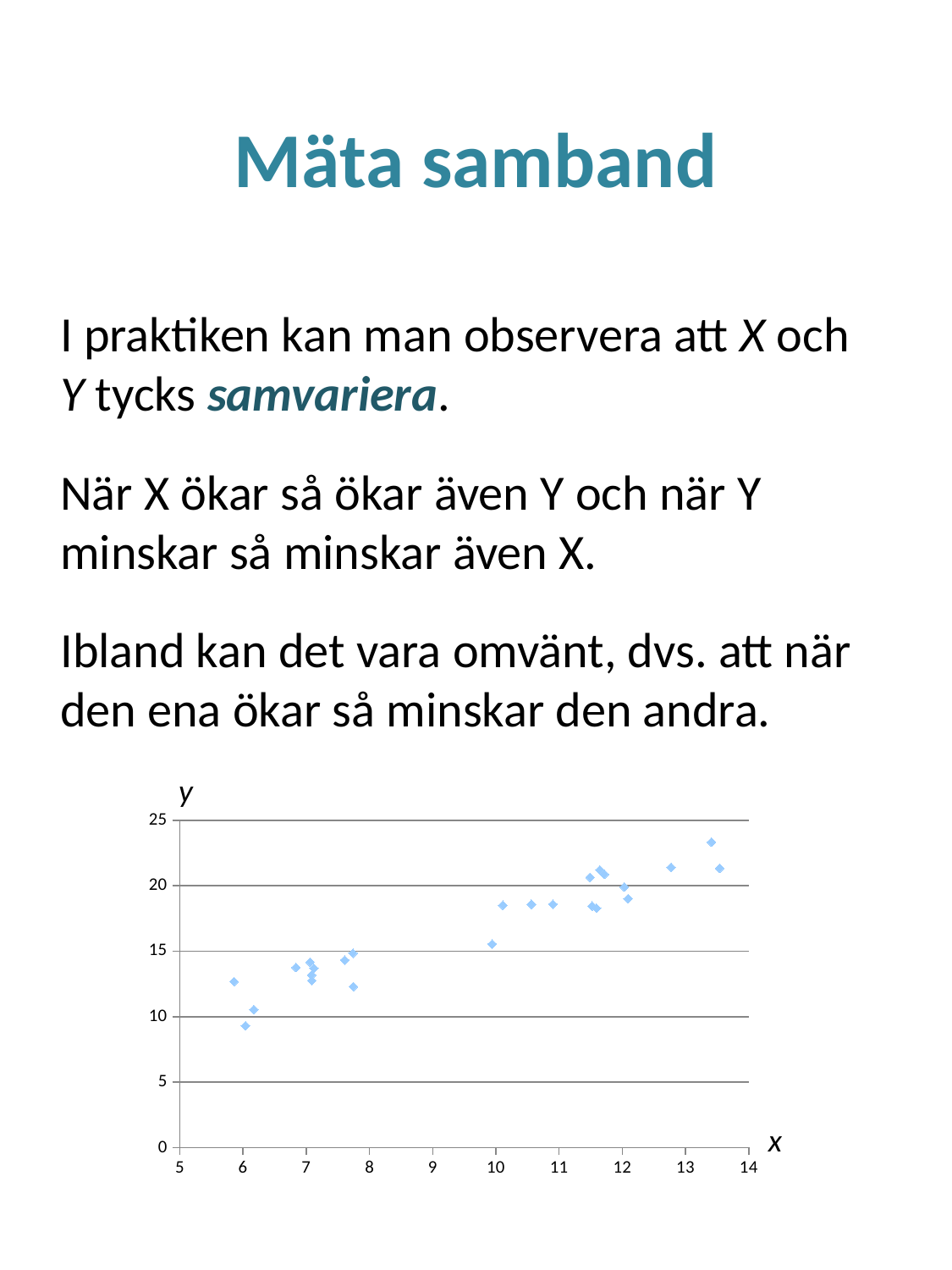
What kind of chart is shown on the slide? scatter chart Are the y values of the points near x = 7 greater or less than 10? greater What range does the x axis of the scatter chart cover? 5 to 14 Is the y value of the highest point in the scatter chart (near x = 13.4) greater or less than 20? greater What is the highest value shown on the y axis of the scatter chart? 25 Is the y value of the lowest point in the scatter chart (near x = 6) greater or less than 10? less Do the y values generally rise or fall as x increases in the scatter chart? rise